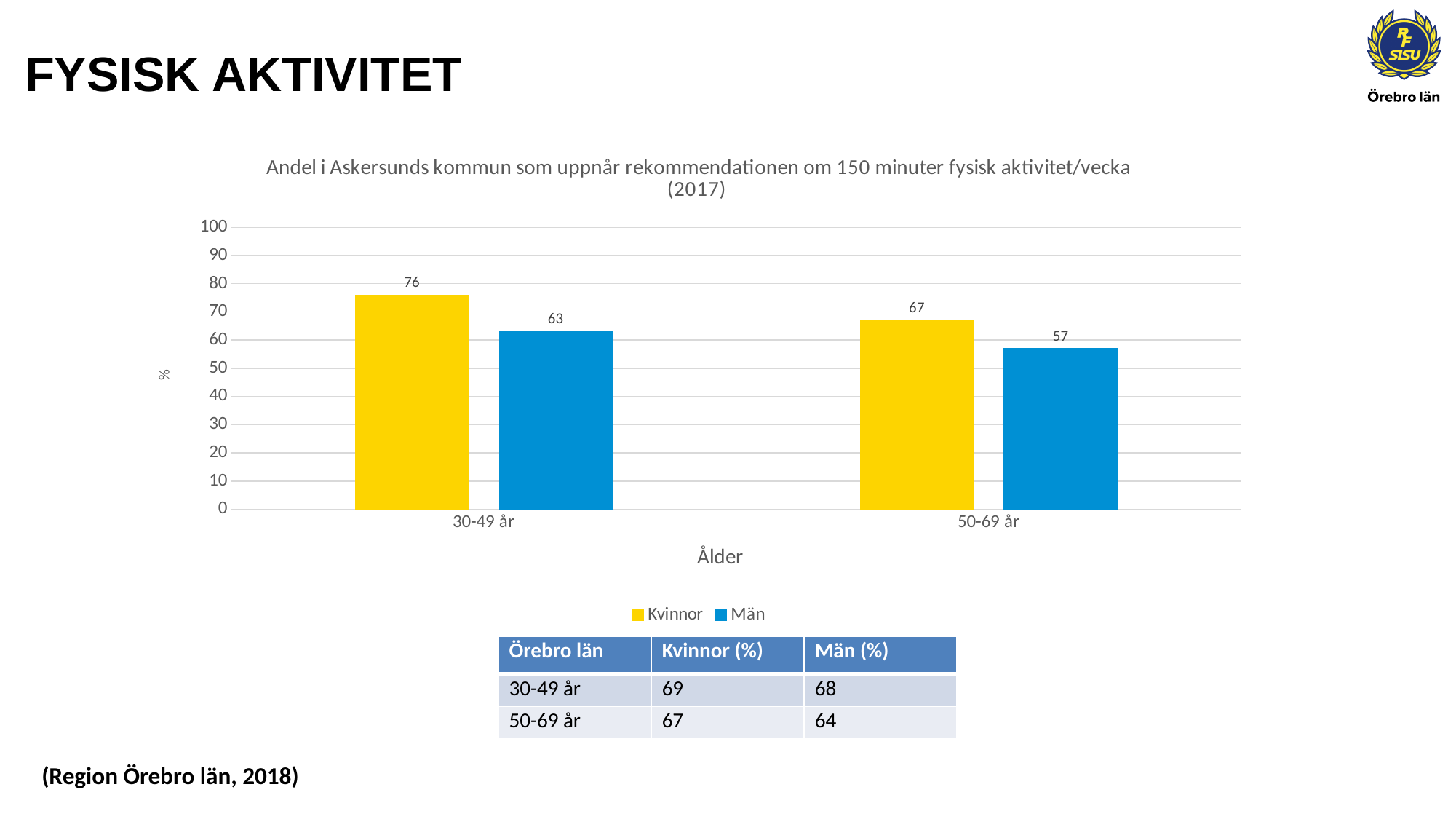
What kind of chart is shown on the slide? Bar chart Which bar has the highest value in the chart? Kvinnor, 30-49 år What is the value for Kvinnor in the 30-49 år age group? 76 What is the difference between Kvinnor and Män in the 30-49 år age group? 13 What is the value for Kvinnor in the 50-69 år age group? 67 Do the Män values rise or fall from the 30-49 år group to the 50-69 år group? Fall How many series does the legend list? 2 What is the value for Män in the 50-69 år age group? 57 What is the difference between the Kvinnor values for 30-49 år and 50-69 år? 9 Which is larger: Män in 30-49 år or Kvinnor in 50-69 år? Kvinnor in 50-69 år How many age groups are shown on the x axis? 2 Which bar has the lowest value in the chart? Män, 50-69 år